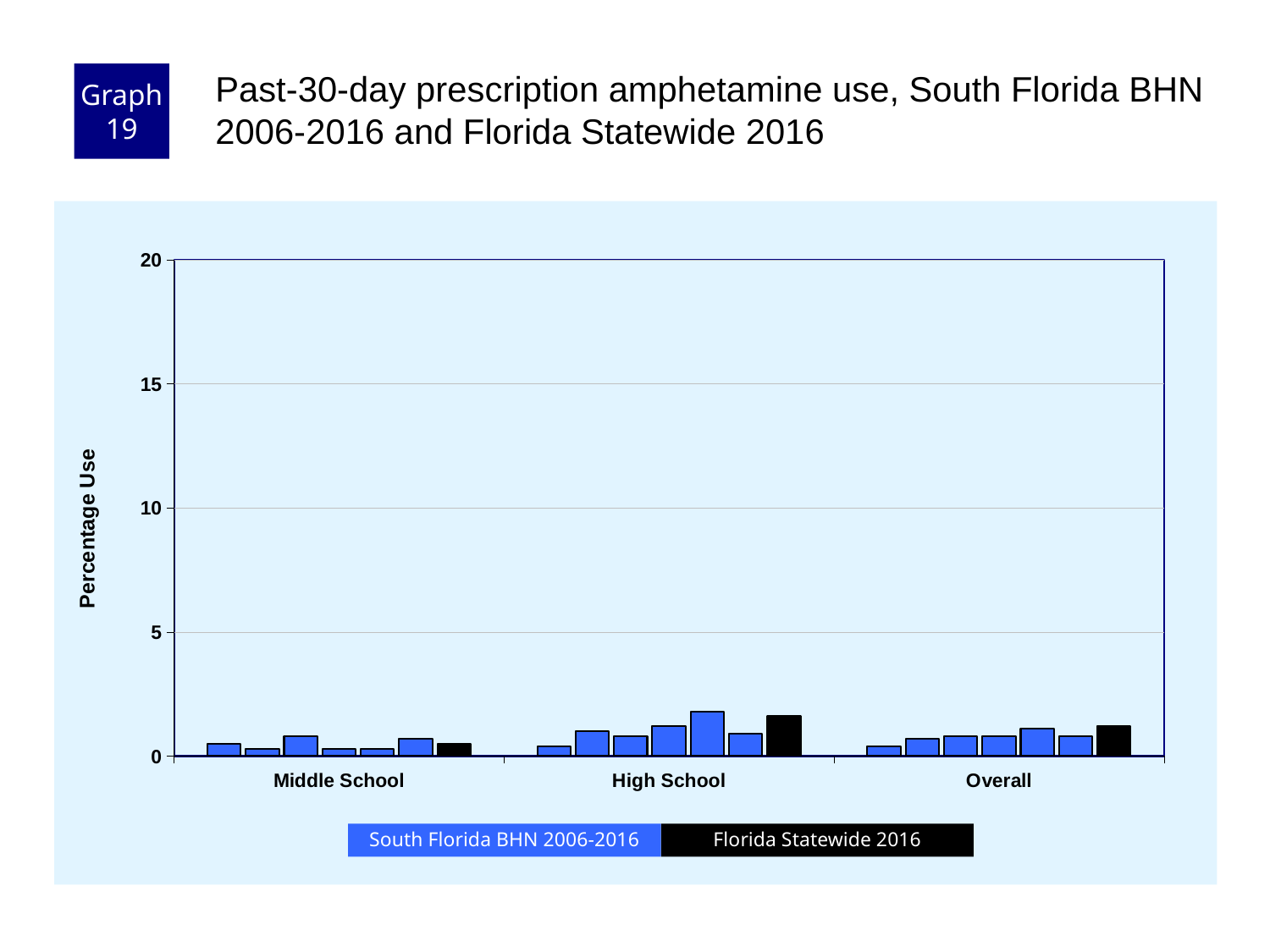
How many bars are plotted in the High School group? 7 Which category has the lowest Florida Statewide 2016 value? Middle School Which is larger, the Florida Statewide 2016 value for High School or for Middle School? High School Is the Florida Statewide 2016 value for High School greater or less than 5? less Which category has the highest Florida Statewide 2016 value? High School Which series is shown in black in the legend? Florida Statewide 2016 How many categories are shown on the x axis? 3 What kind of chart is shown on the slide? bar chart How many series does the legend list? 2 Is the Florida Statewide 2016 value for Overall greater or less than 10? less What is the label of the y axis? Percentage Use Which is larger, the Florida Statewide 2016 value for Overall or for Middle School? Overall